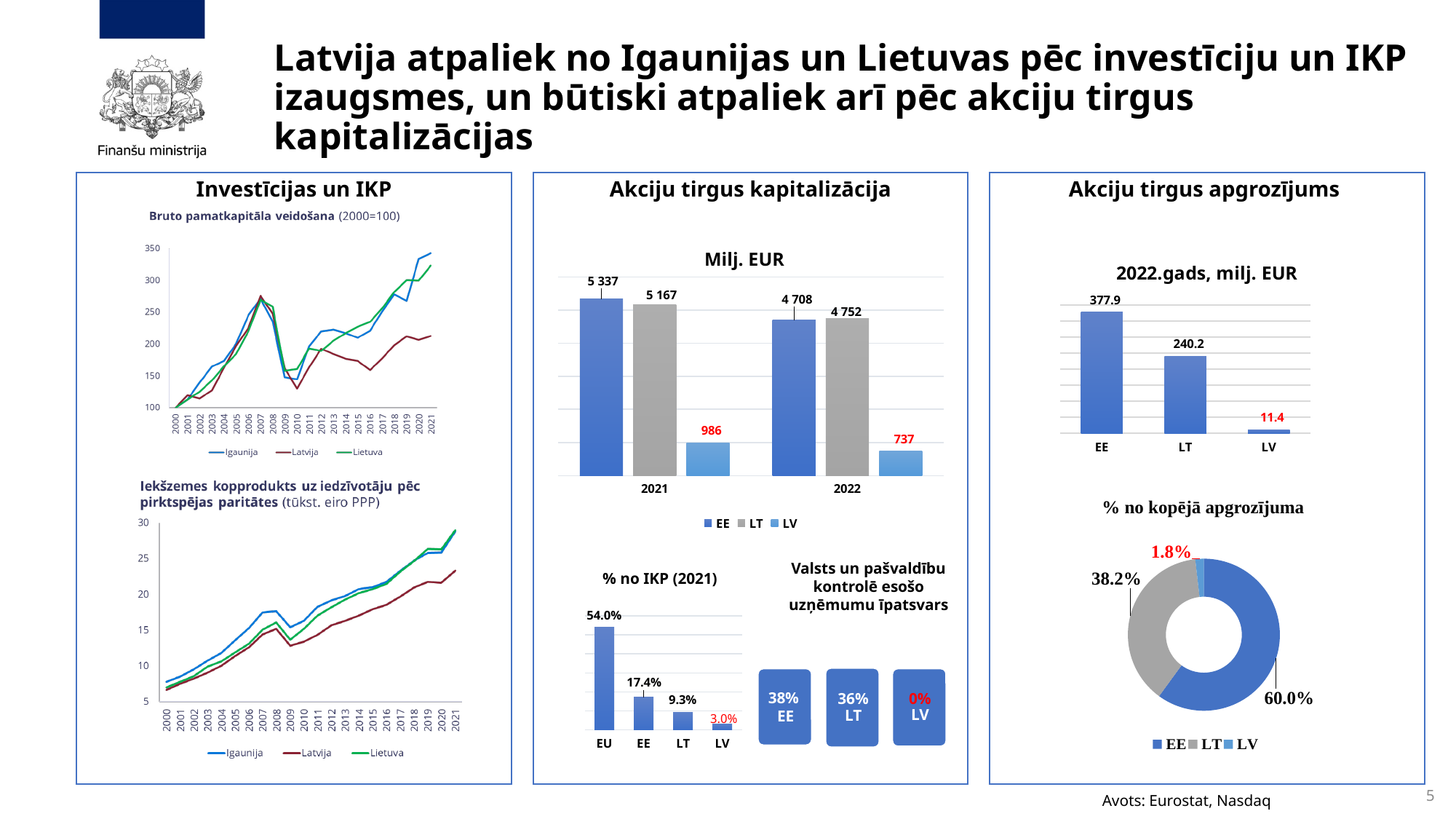
In the 'Milj. EUR' stock market capitalisation chart, how many series does the legend list? 3 In the 'Bruto pamatkapitāla veidošana (2000=100)' chart, how many series does the legend list? 3 In the '% no IKP (2021)' chart, which category has the highest value? EU In the 'Milj. EUR' stock market capitalisation chart, what is the value for LV in 2021? 986 In the 'Milj. EUR' stock market capitalisation chart, what is the difference between EE and LV in 2021? 4 351 In the '2022.gads, milj. EUR' stock market turnover chart, what is the difference between EE and LT? 137.7 What kind of chart is the '% no kopējā apgrozījuma' chart? Doughnut (pie) chart In the '2022.gads, milj. EUR' stock market turnover chart, what is the value for LT? 240.2 In the 'Milj. EUR' stock market capitalisation chart, what is the value for EE in 2022? 4 708 In the '% no kopējā apgrozījuma' chart, what share does LT have? 38.2% In the '% no IKP (2021)' chart, what is the value for LT? 9.3% In the '2022.gads, milj. EUR' stock market turnover chart, which category has the lowest value? LV